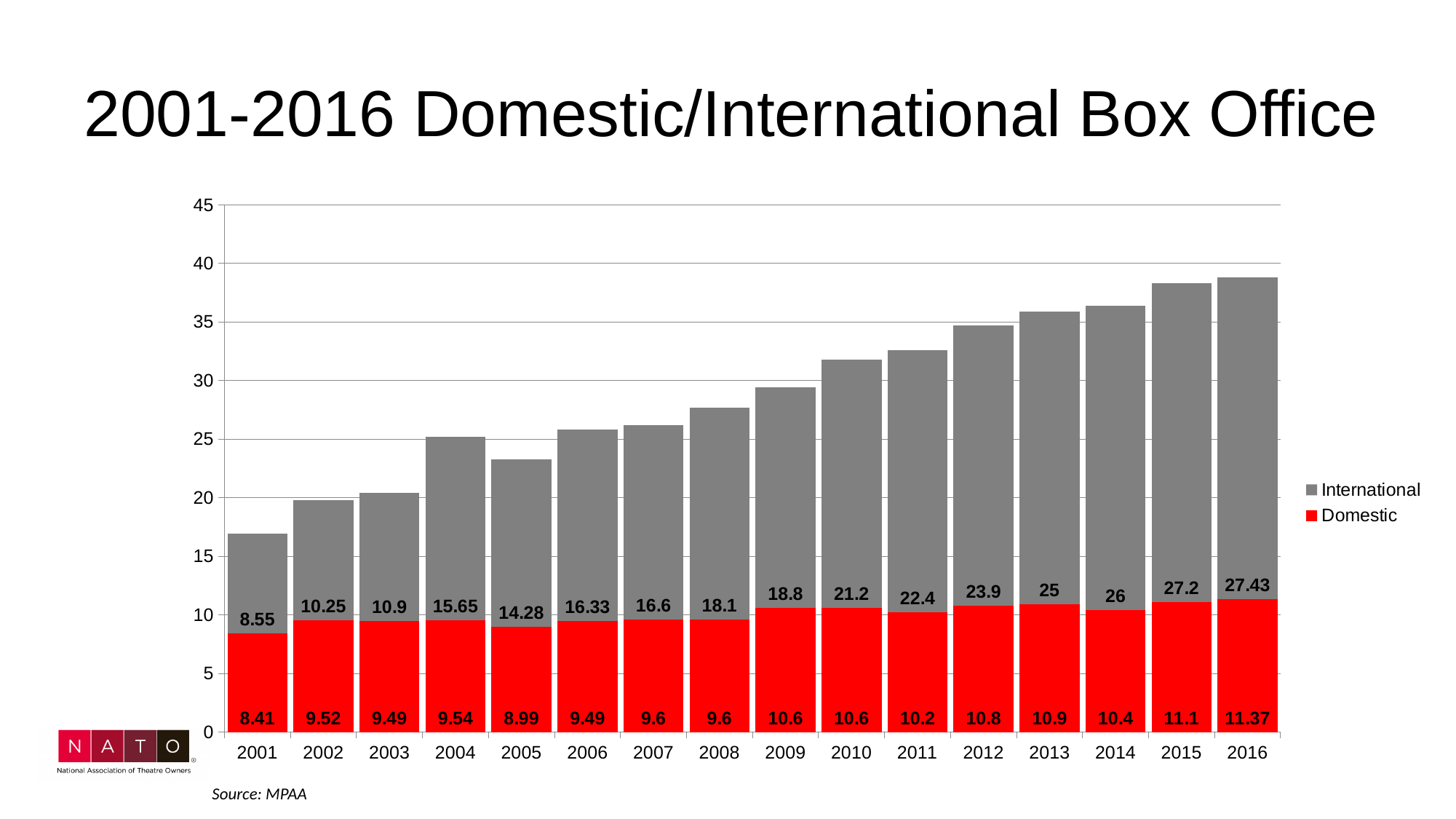
What is the total of the stacked bar for 2016? 38.8 Do the International values generally rise or fall from 2001 to 2016? Rise How many years are shown on the x axis? 16 Which year has the lowest Domestic value? 2001 Which is larger, the International value for 2005 or for 2004? 2004 What is the difference between the International values for 2016 and 2001? 18.88 Which year has the highest International value? 2016 What is the Domestic value for 2016? 11.37 What kind of chart is shown on the slide? Stacked bar chart How many series does the legend list? 2 Is the total stacked bar for 2010 greater or less than 30? greater What is the International value for 2004? 15.65